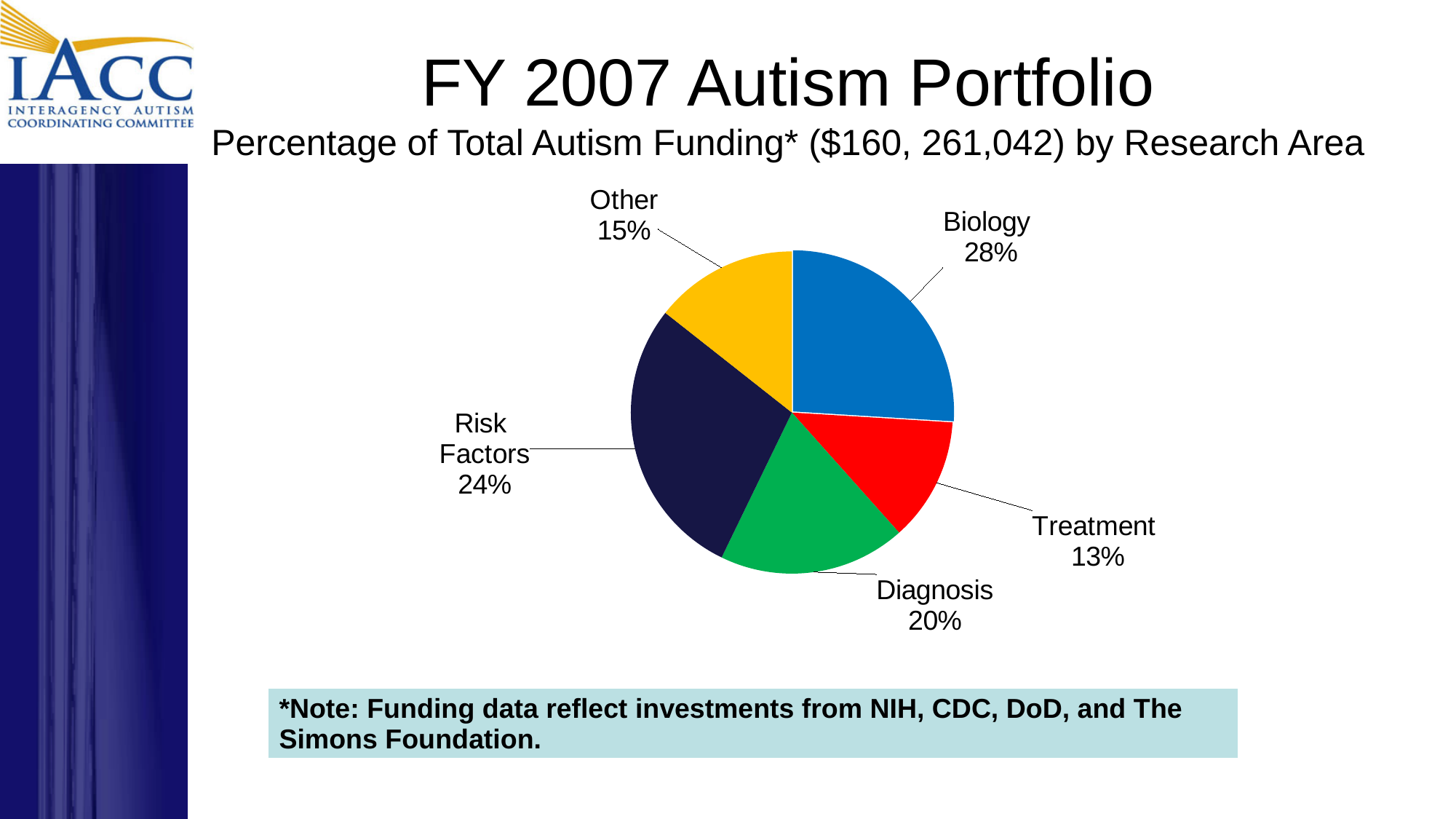
What percentage of total autism funding went to Diagnosis? 20% Which received a larger share of funding, Diagnosis or Risk Factors? Risk Factors Which research area received the smallest share of funding? Treatment What percentage of total autism funding went to Risk Factors? 24% What is the total autism funding amount stated in the chart subtitle? $160, 261,042 How many percentage points larger is the Biology share than the Other share? 13 What percentage of total autism funding went to Treatment? 13% What is the combined share of Diagnosis and Treatment? 33% What kind of chart is shown on the slide? Pie chart What percentage of total autism funding went to Biology? 28% Which research area received the largest share of funding? Biology How many research areas are shown in the pie chart? 5